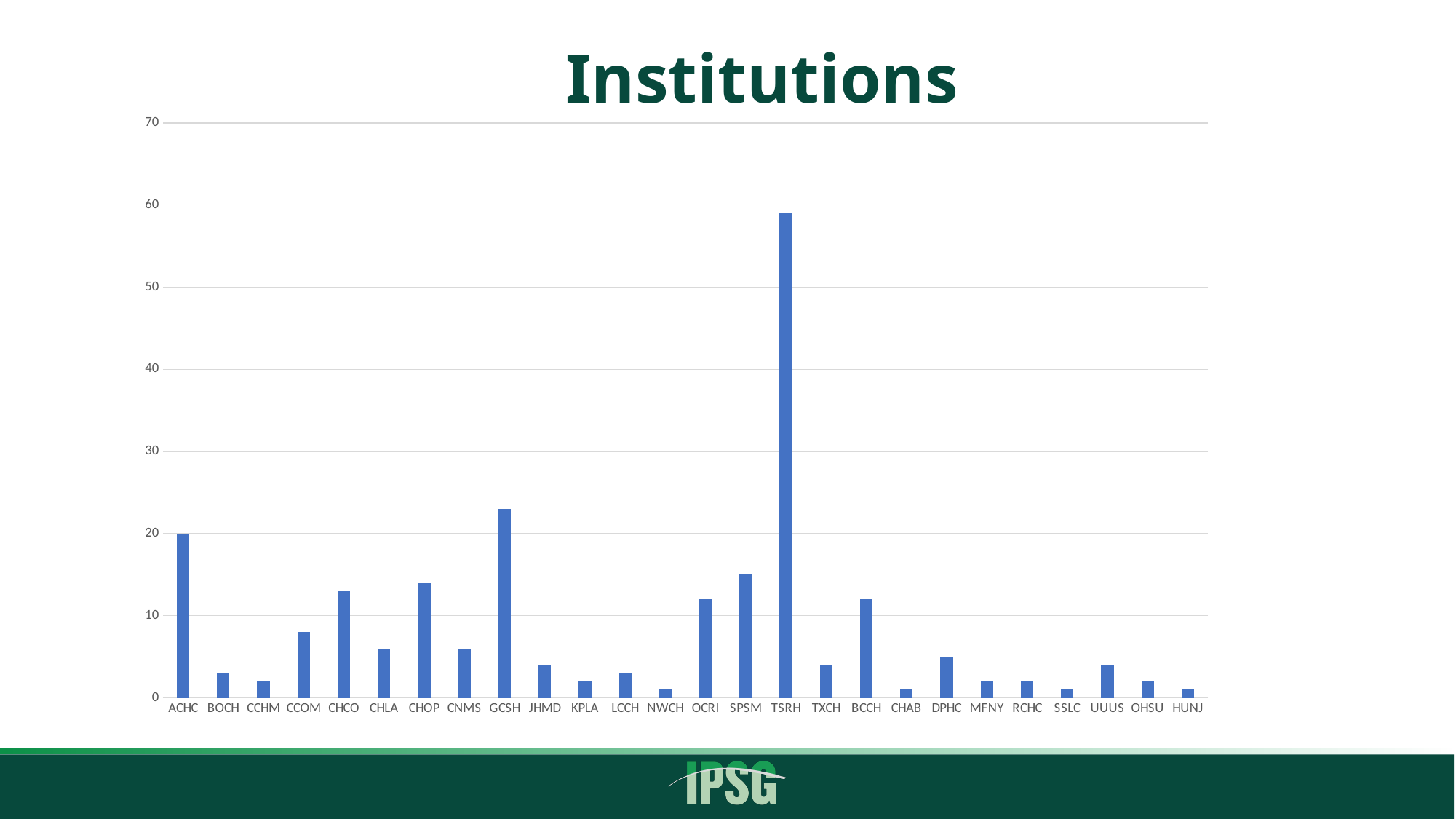
How many institutions are shown on the x axis of the chart? 26 Is the value for CCOM greater or less than 10? less What kind of chart is shown on the slide? bar chart What is the value for ACHC? 20 Which is larger, the value for CCOM or the value for CHLA? CCOM Is the value for SPSM greater or less than 10? greater Is the value for GCSH greater or less than 20? greater Which is larger, the value for GCSH or the value for ACHC? GCSH Which institution has the highest bar in the chart? TSRH What is the title of the chart? Institutions Which is larger, the value for SPSM or the value for OCRI? SPSM